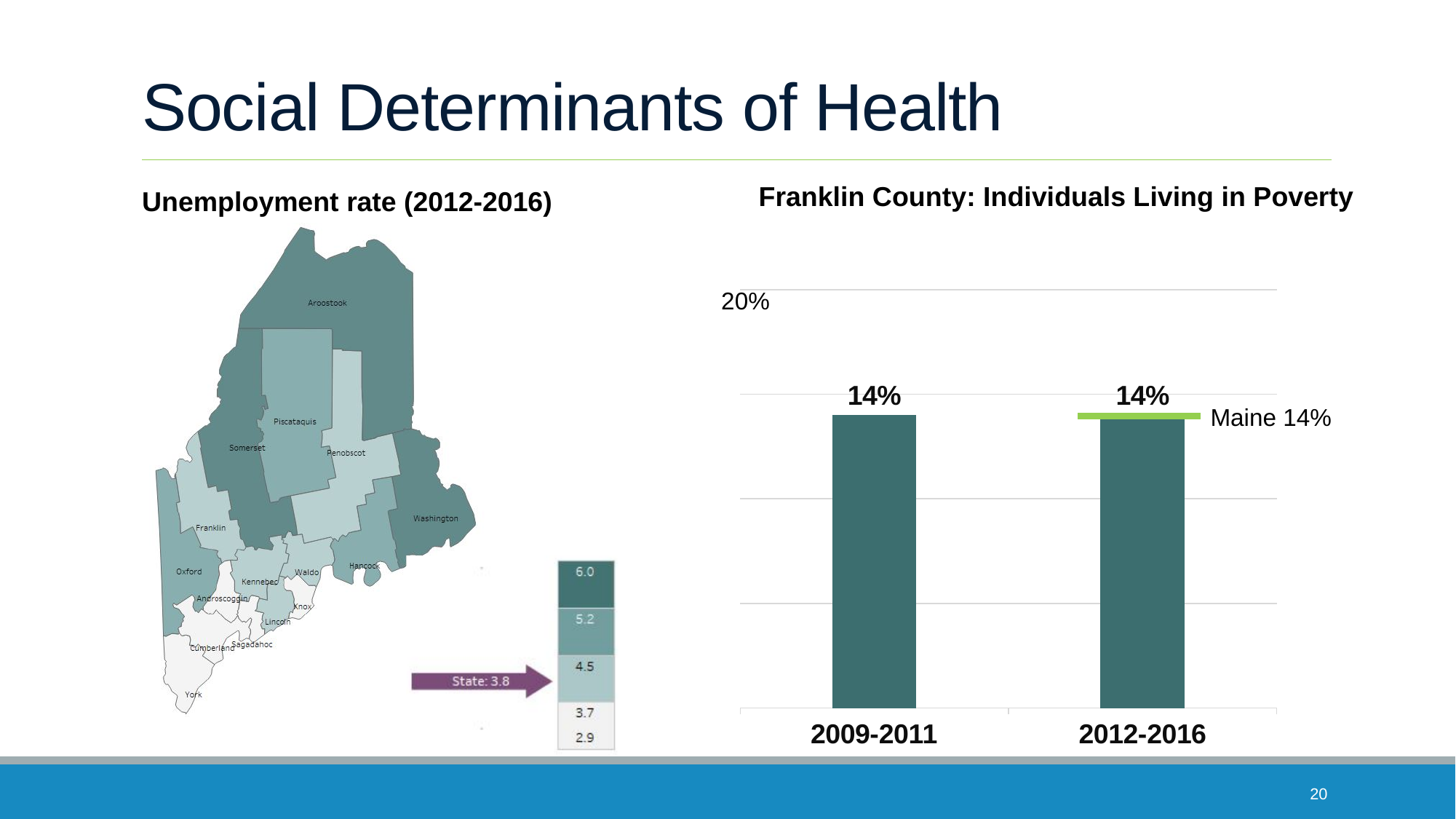
On the Franklin County: Individuals Living in Poverty chart, what is the difference between the 2009-2011 and 2012-2016 values? 0% On the Franklin County: Individuals Living in Poverty chart, do the values rise, fall, or stay the same from 2009-2011 to 2012-2016? stay the same On the Franklin County: Individuals Living in Poverty chart, what is the Maine value shown by the reference line? Maine 14% On the Franklin County: Individuals Living in Poverty chart, how many bars are plotted? 2 On the Franklin County: Individuals Living in Poverty chart, what is the highest axis tick label shown? 20% On the Franklin County: Individuals Living in Poverty chart, what is the value for 2009-2011? 14% On the Franklin County: Individuals Living in Poverty chart, is the value for 2012-2016 greater or less than 20%? less What kind of chart is the Franklin County: Individuals Living in Poverty chart? bar chart On the Unemployment rate (2012-2016) map, what is the highest value shown in the colour legend? 6.0 On the Franklin County: Individuals Living in Poverty chart, what is the value for 2012-2016? 14% On the Unemployment rate (2012-2016) map, what is the state unemployment rate indicated by the arrow? 3.8 What is the title of the chart on the right side of the slide? Franklin County: Individuals Living in Poverty